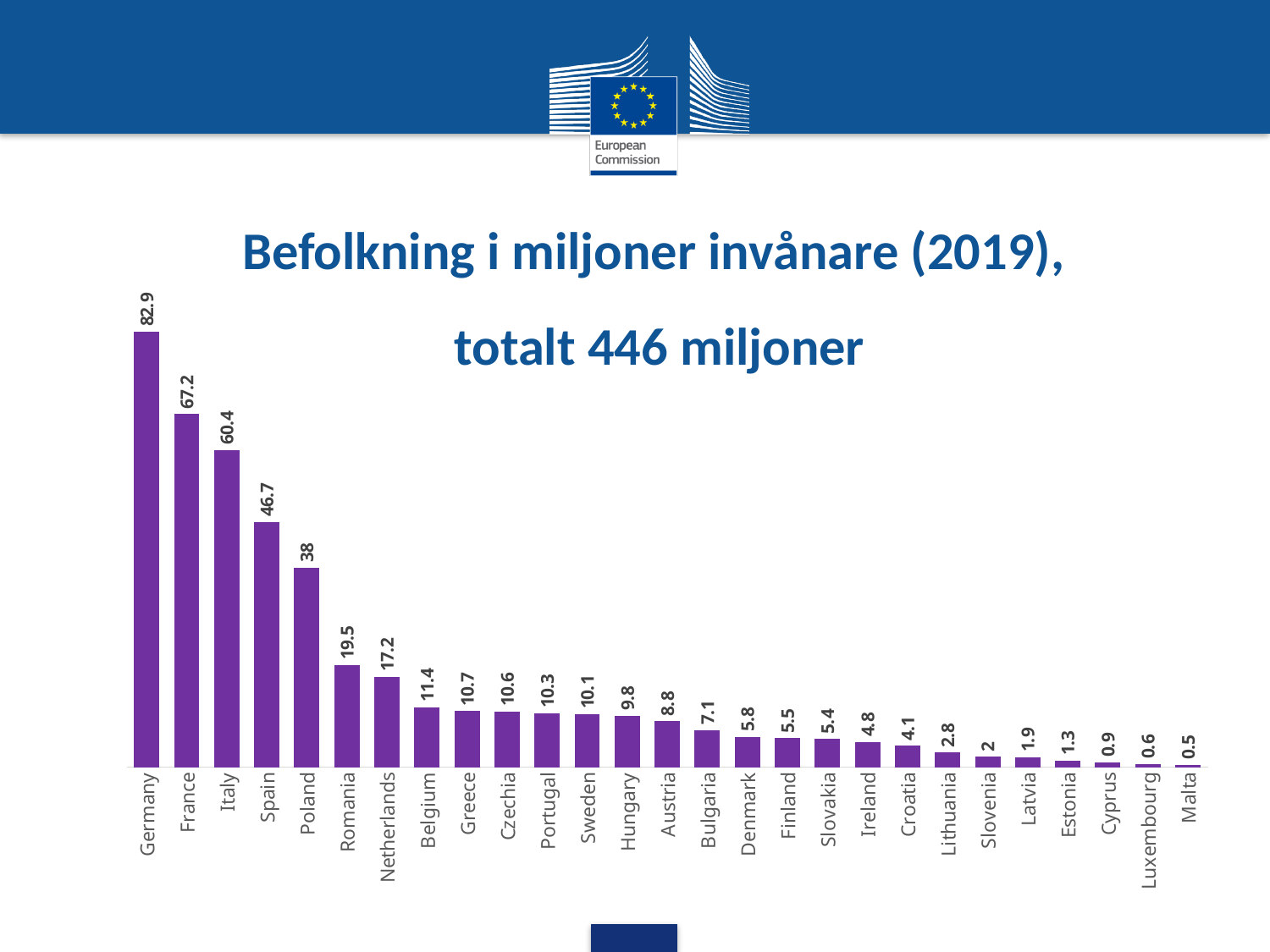
What is the value shown for Slovenia? 2 What is the value shown for Poland? 38 Which country has the lowest value in the chart? Malta Which has a larger value, Romania or Netherlands? Romania What kind of chart is shown on the slide? Bar chart What is the title of the chart? Befolkning i miljoner invånare (2019), totalt 446 miljoner What is the value shown for Germany? 82.9 Do the values rise or fall from left to right along the x axis? Fall Which country has the highest value in the chart? Germany What is the value shown for Netherlands? 17.2 What is the difference between the values for France and Italy? 6.8 How many countries are shown in the chart? 27